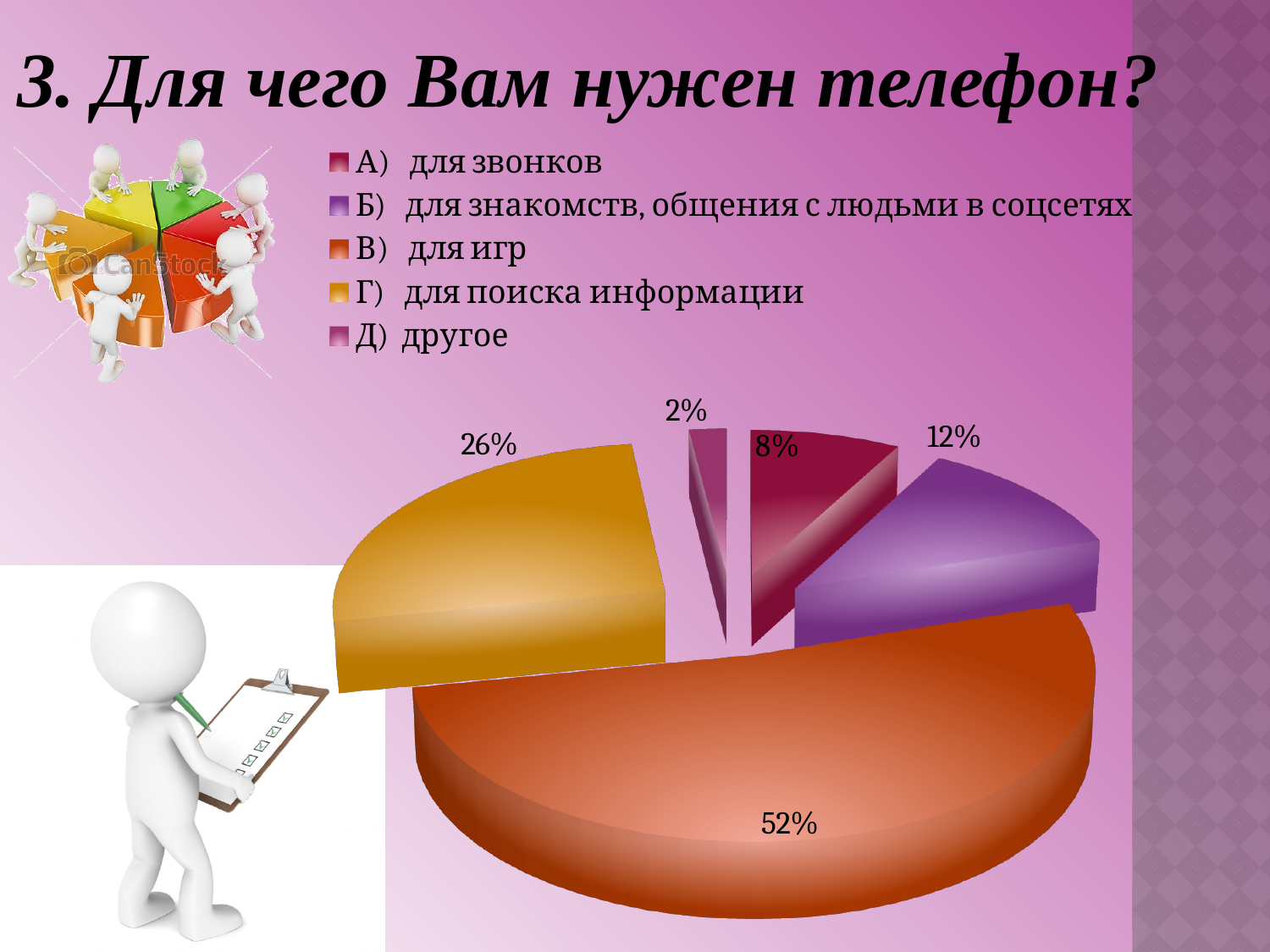
Which is larger: the share for "А) для звонков" or the share for "Б) для знакомств, общения с людьми в соцсетях"? Б) для знакомств, общения с людьми в соцсетях What percentage of the pie chart is for "Г) для поиска информации"? 26% What type of chart is shown on the slide? Pie chart What percentage of the pie chart is for "А) для звонков"? 8% What percentage of the pie chart is for "В) для игр"? 52% Which category has the largest share of the pie chart? В) для игр How many categories does the legend of the pie chart list? 5 What percentage of the pie chart is for "Б) для знакомств, общения с людьми в соцсетях"? 12% What percentage of the pie chart is for "Д) другое"? 2% Which category has the smallest share of the pie chart? Д) другое What is the title of the slide containing the pie chart? 3. Для чего Вам нужен телефон? What is the difference in percentage points between "В) для игр" and "Г) для поиска информации"? 26